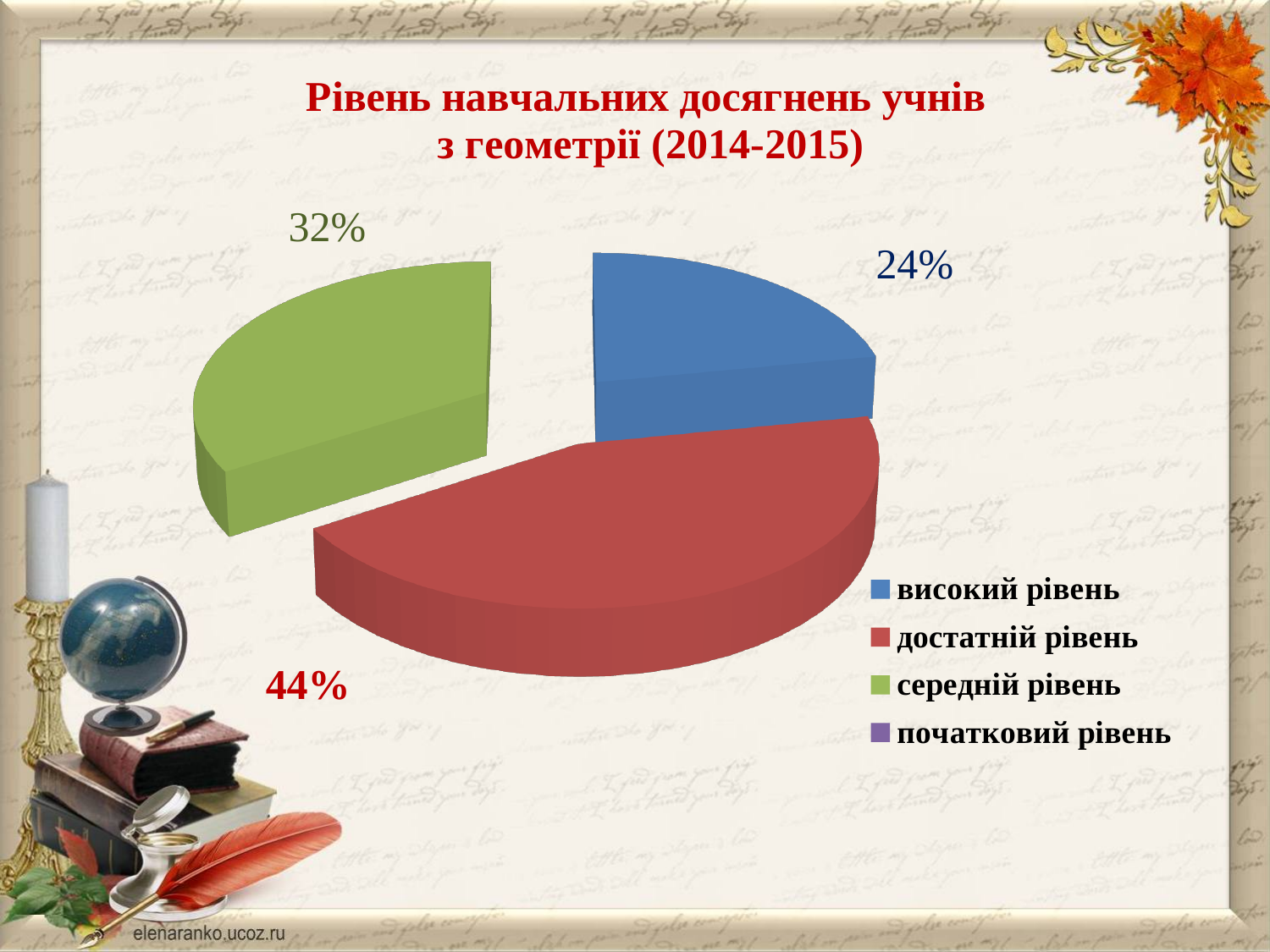
Which level has the largest share of the pie? достатній рівень What is the title of the chart? Рівень навчальних досягнень учнів з геометрії (2014-2015) Which of the labelled slices has the smallest share of the pie? високий рівень Which is larger: the share for 'середній рівень' or the share for 'високий рівень'? середній рівень What colour is the slice for 'достатній рівень'? red What type of chart is shown on the slide? pie chart What is the combined share of 'високий рівень' and 'середній рівень'? 56% What percentage of students are at the 'достатній рівень' level? 44% What is the difference in percentage points between 'достатній рівень' and 'високий рівень'? 20 What percentage of students are at the 'високий рівень' level? 24% How many entries does the legend list? 4 What percentage of students are at the 'середній рівень' level? 32%